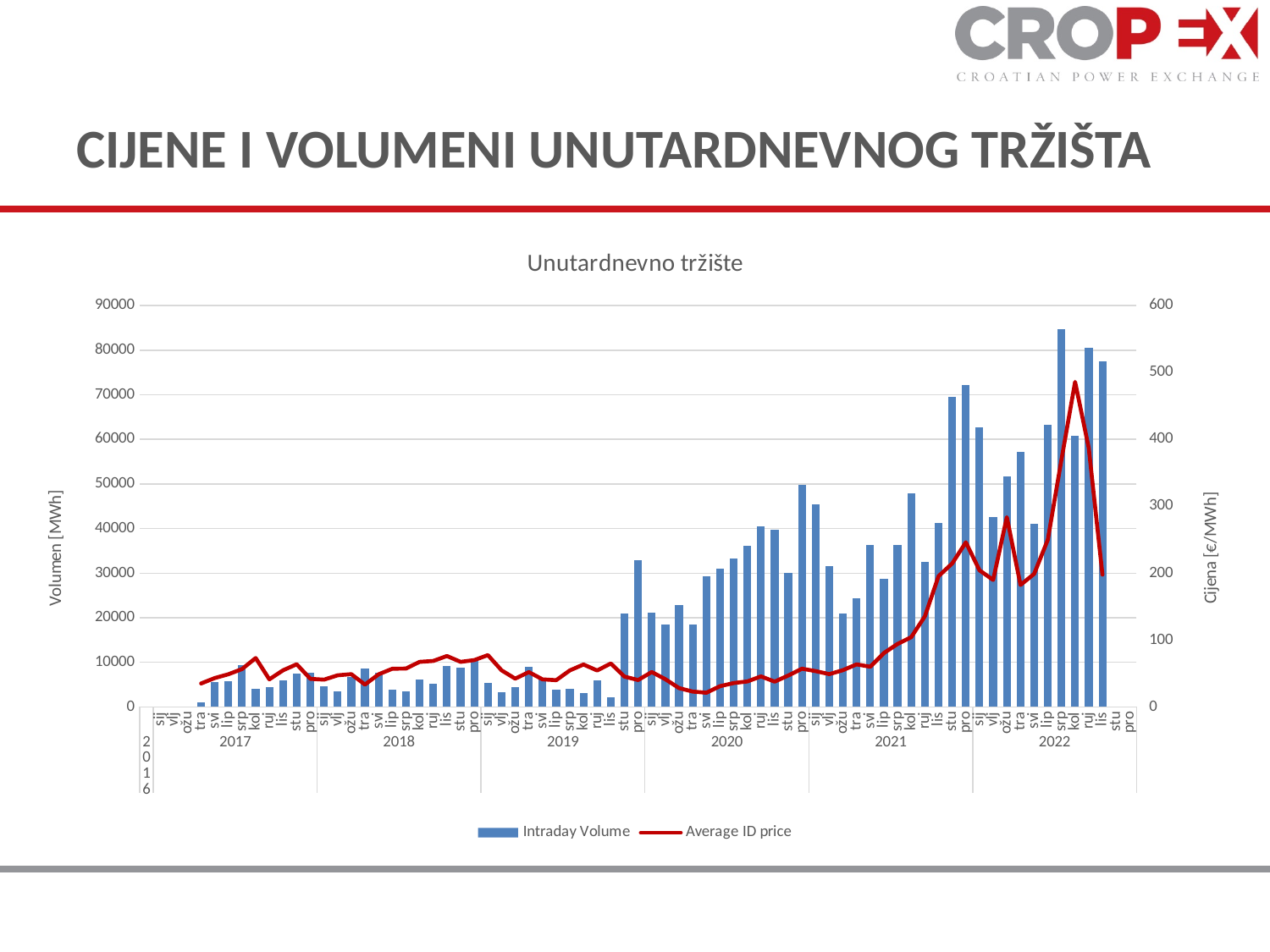
Overall, do the Intraday Volume bars rise or fall from 2017 to 2022? rise Is the peak of the Average ID price line greater or less than 400 €/MWh? greater Is the Average ID price in 2018 greater or less than 100 €/MWh? less Which year has higher Intraday Volume bars, 2019 or 2021? 2021 Is the tallest Intraday Volume bar greater or less than 80000 MWh? greater What are the two series named in the legend? Intraday Volume and Average ID price What is the maximum value shown on the left (Volumen) axis? 90000 What kind of chart is shown on the slide? A combined bar and line chart In which year does the tallest Intraday Volume bar occur? 2022 What is the title of the chart? Unutardnevno tržište How many series does the legend list? 2